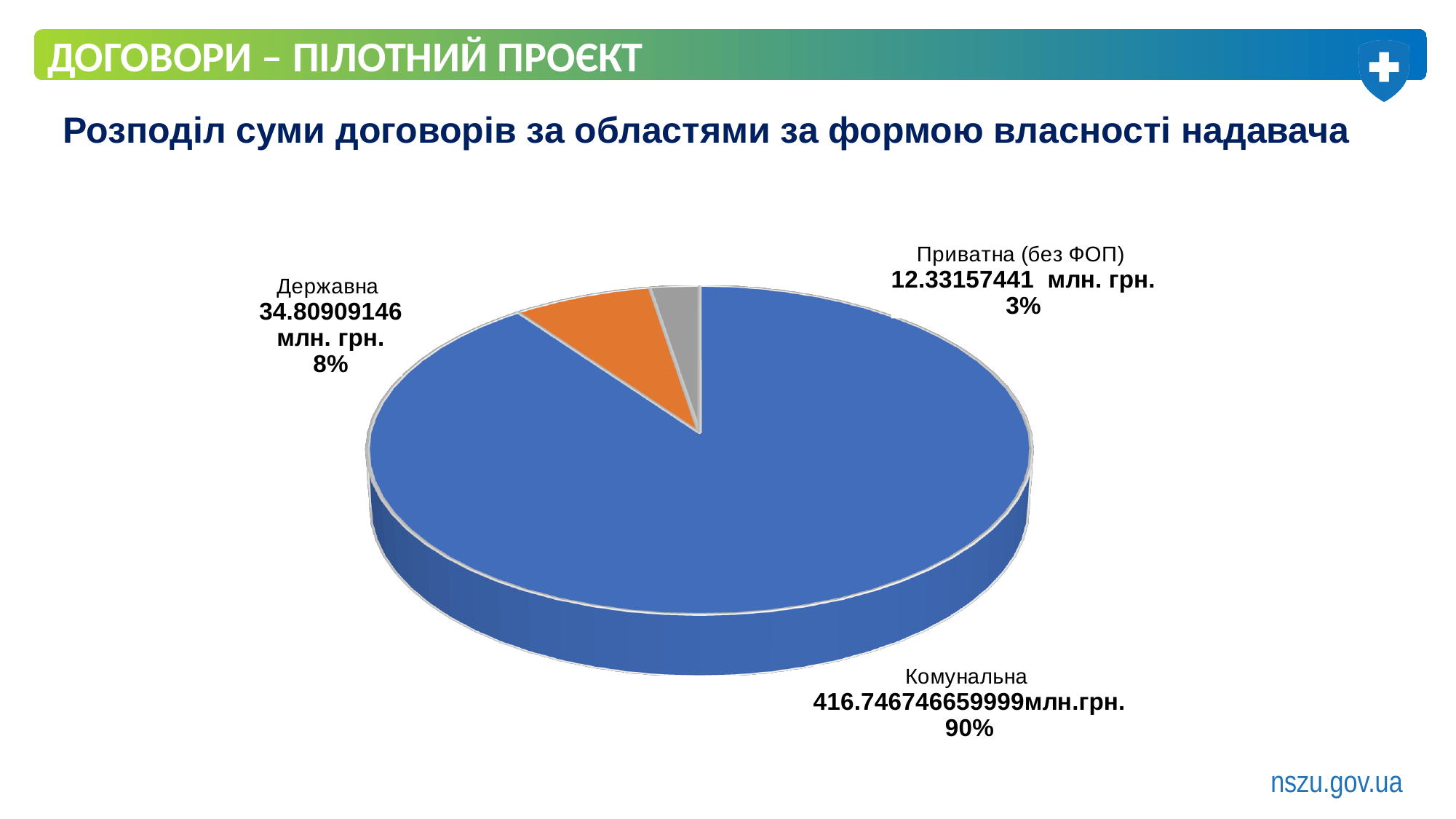
What share of the pie does Приватна (без ФОП) account for? 3% Which is larger, the value for Державна or the value for Приватна (без ФОП)? Державна What colour is the Державна slice of the pie? orange What share of the pie does Державна account for? 8% What is the value shown for Приватна (без ФОП)? 12.33157441 млн. грн. What is the value shown for Комунальна? 416.746746659999 млн.грн. What is the value shown for Державна? 34.80909146 млн. грн. Which category has the largest share of the pie? Комунальна What share of the pie does Комунальна account for? 90% How many slices does the pie chart have? 3 What kind of chart is shown on the slide? pie chart Which category has the smallest share of the pie? Приватна (без ФОП)